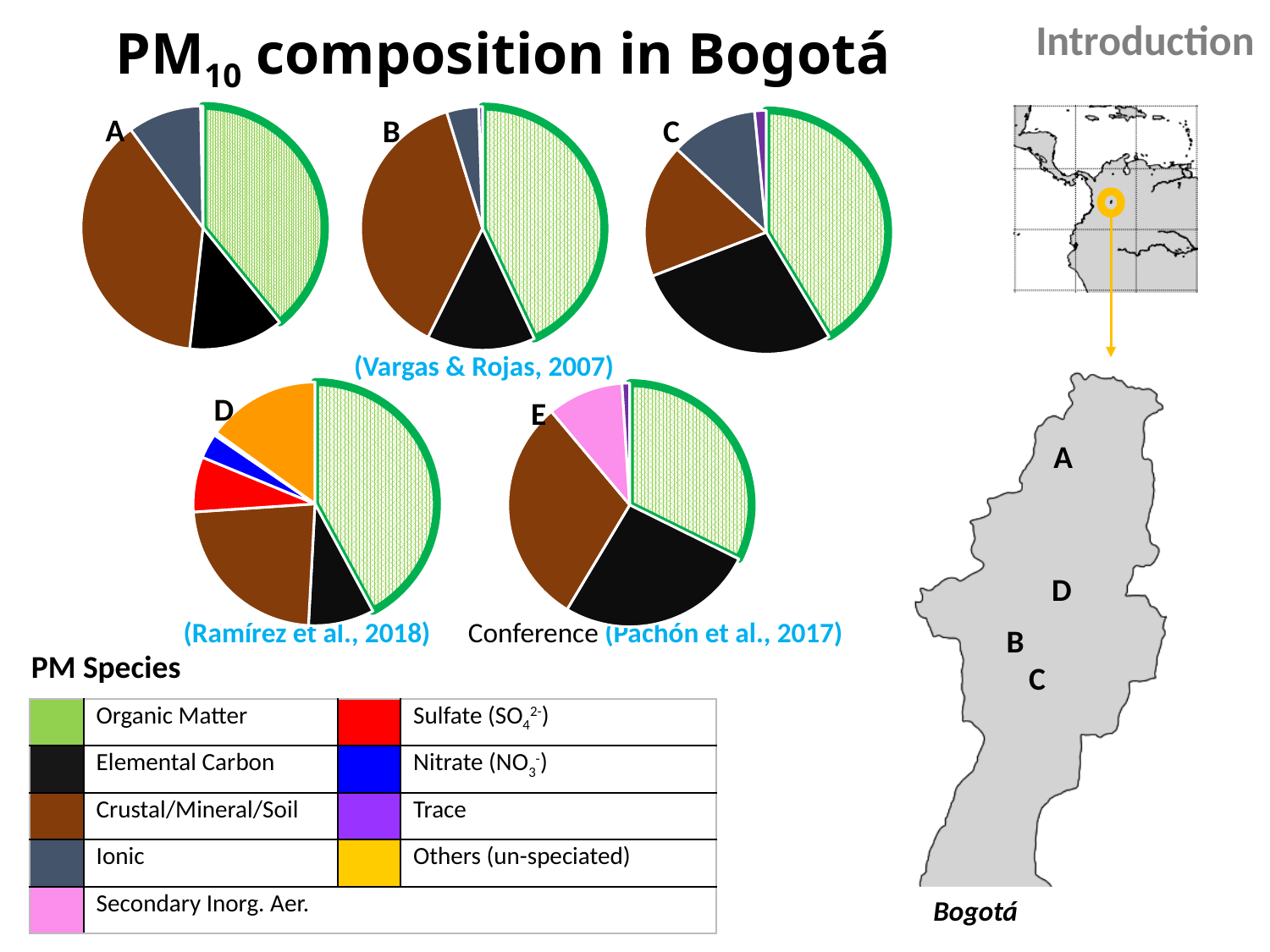
In pie chart C, which PM species has the largest slice? Organic Matter What kind of charts are used to show the PM10 composition in Bogotá? Pie charts In pie chart C, which slice is larger: Elemental Carbon or Crustal/Mineral/Soil? Elemental Carbon How many pie charts are shown on the slide? 5 In pie chart D, which slice is larger: Others (un-speciated) or Sulfate (SO42-)? Others (un-speciated) In pie chart D, which PM species has the largest slice? Organic Matter In pie chart C, which PM species has the smallest slice? Trace Which colour represents Organic Matter in the legend? Green How many PM species does the legend list? 9